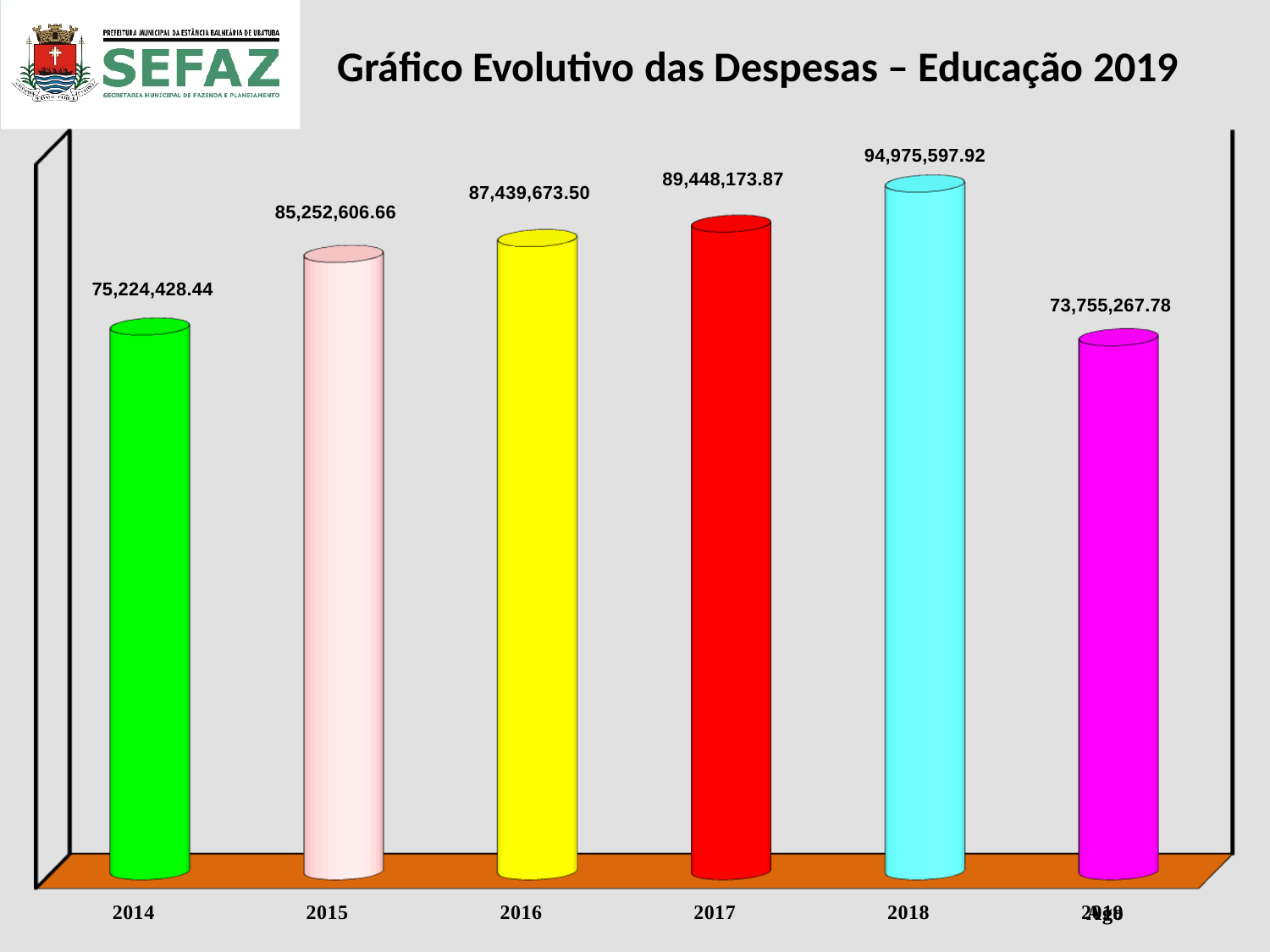
What is the value shown for 2014? 75,224,428.44 Which year has the highest value? 2018 Which is larger, the value for 2017 or the value for 2015? 2017 What is the value shown for 2016? 87,439,673.50 How many bars are plotted on the chart? 6 What is the difference between the values for 2015 and 2014? 10,028,178.22 Which bar has the lowest value? 2019 (the rightmost bar) What is the value shown on the rightmost bar (2019)? 73,755,267.78 What is the difference between the values for 2018 and 2014? 19,751,169.48 What is the title of the chart? Gráfico Evolutivo das Despesas – Educação 2019 What kind of chart is shown on the slide? Bar chart What is the value shown for 2018? 94,975,597.92